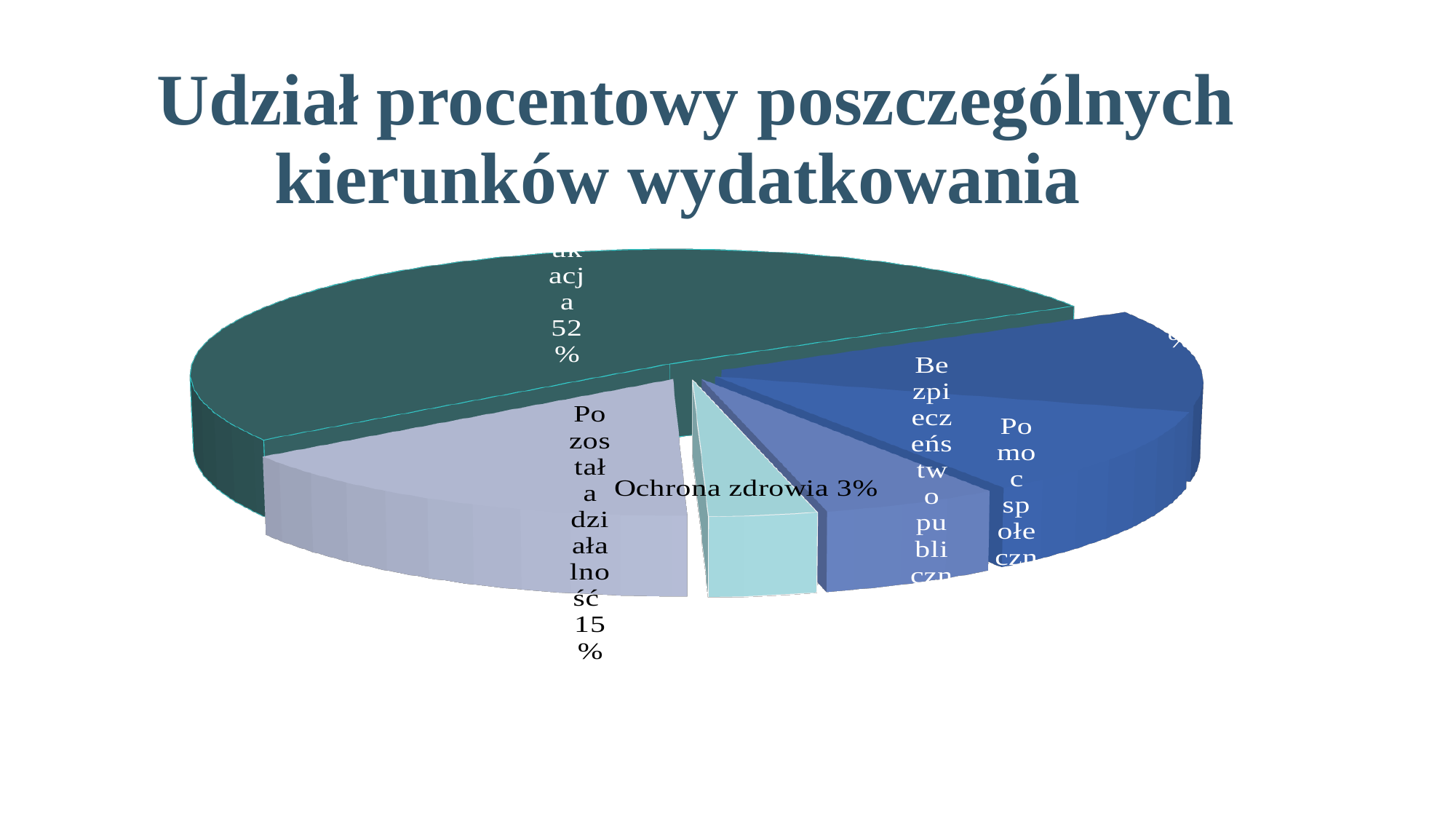
What percentage share is shown for Pozostała działalność? 15% What is the difference in percentage points between the Edukacja share and the Pozostała działalność share? 37% Which category has the smallest slice of the pie? Ochrona zdrowia Which is larger, the share for Pozostała działalność or the share for Ochrona zdrowia? Pozostała działalność Which is larger, the slice for Edukacja or the slice for Pomoc społeczna? Edukacja Which category has the largest slice of the pie? Edukacja What is the difference in percentage points between the Pozostała działalność share and the Ochrona zdrowia share? 12% What kind of chart is shown on the slide? pie chart What percentage share is shown for Edukacja? 52% What percentage share is shown for Ochrona zdrowia? 3% How many slices does the pie chart have? 6 What is the title of the chart? Udział procentowy poszczególnych kierunków wydatkowania